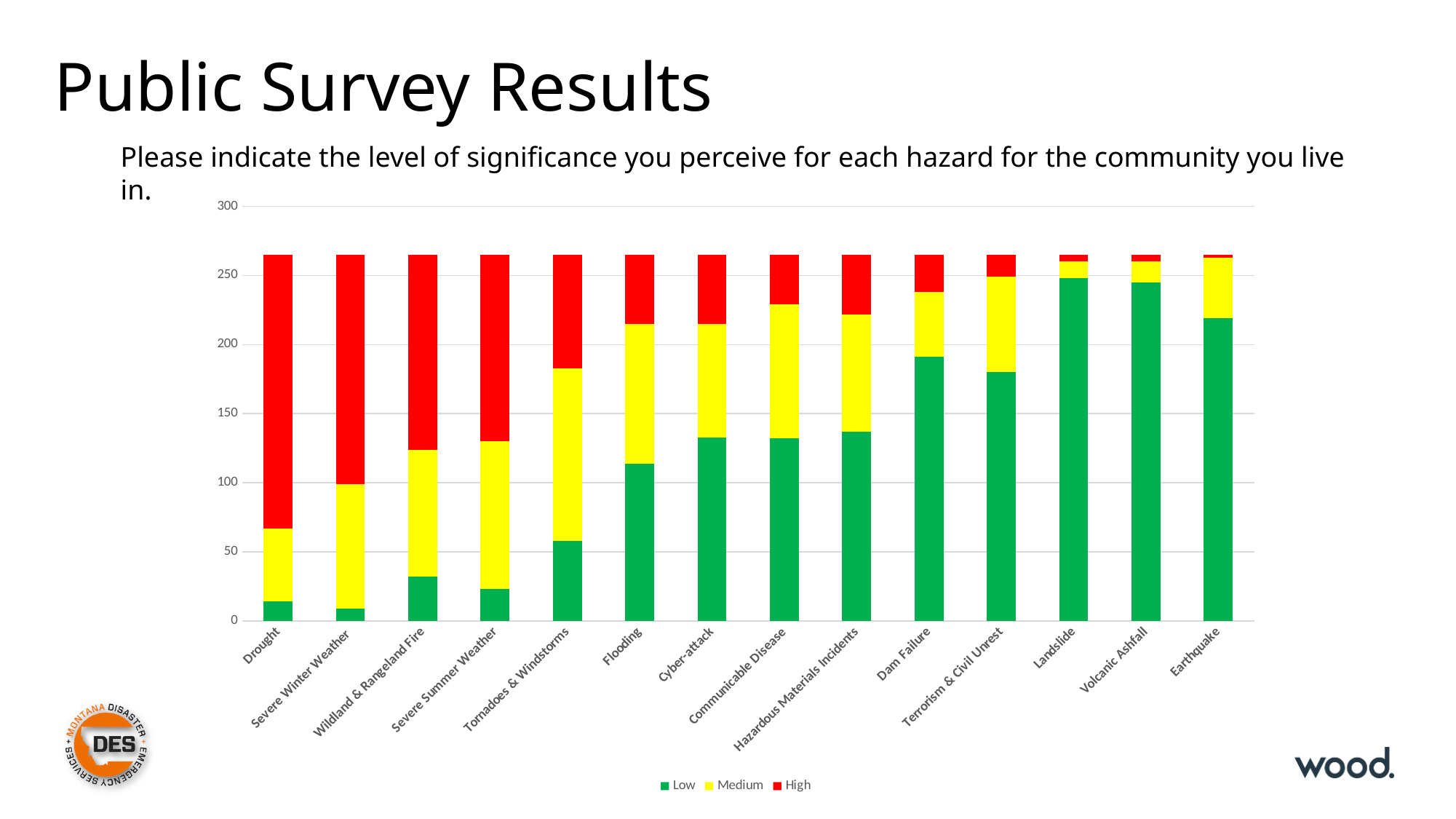
Is the Low value for Drought greater or less than 50? less How many series does the chart legend list? 3 Which colour represents the Medium series in the chart? Yellow How many hazard categories are shown on the x axis of the chart? 14 Which series is shown in green in the chart? Low Which has a larger Low value, Flooding or Drought? Flooding Is the Low value for Earthquake greater or less than 200? greater What kind of chart is shown on the slide? Stacked bar chart Which has a larger High value, Drought or Flooding? Drought Which hazard has the largest High (red) segment? Drought Is the Low value for Flooding greater or less than 100? greater